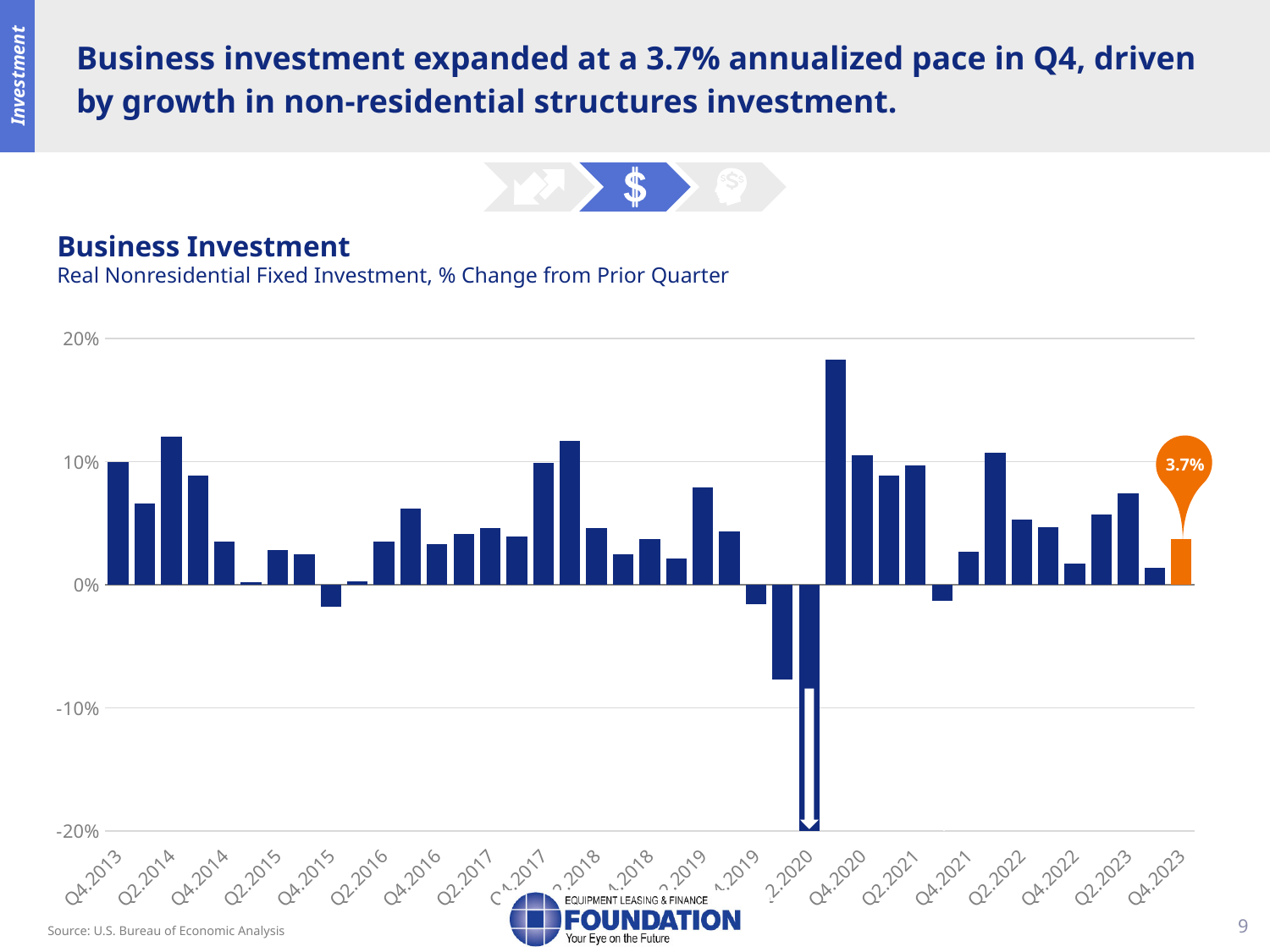
Is the value for Q4.2023 greater or less than 10%? less What colour is the bar for Q4.2023 in the Business Investment chart? orange What is the subtitle of the Business Investment chart? Real Nonresidential Fixed Investment, % Change from Prior Quarter Which quarter has the lowest value in the Business Investment chart? Q2.2020 What is the value for Q4.2023 in the Business Investment chart? 3.7% Which is larger, the value for Q4.2013 or the value for Q4.2023? Q4.2013 What kind of chart is used to show Business Investment? bar chart Is the value for Q4.2023 greater or less than 0%? greater Which is larger, the value for Q4.2023 or the value for Q2.2020? Q4.2023 Is the value for Q2.2020 greater or less than -10%? less